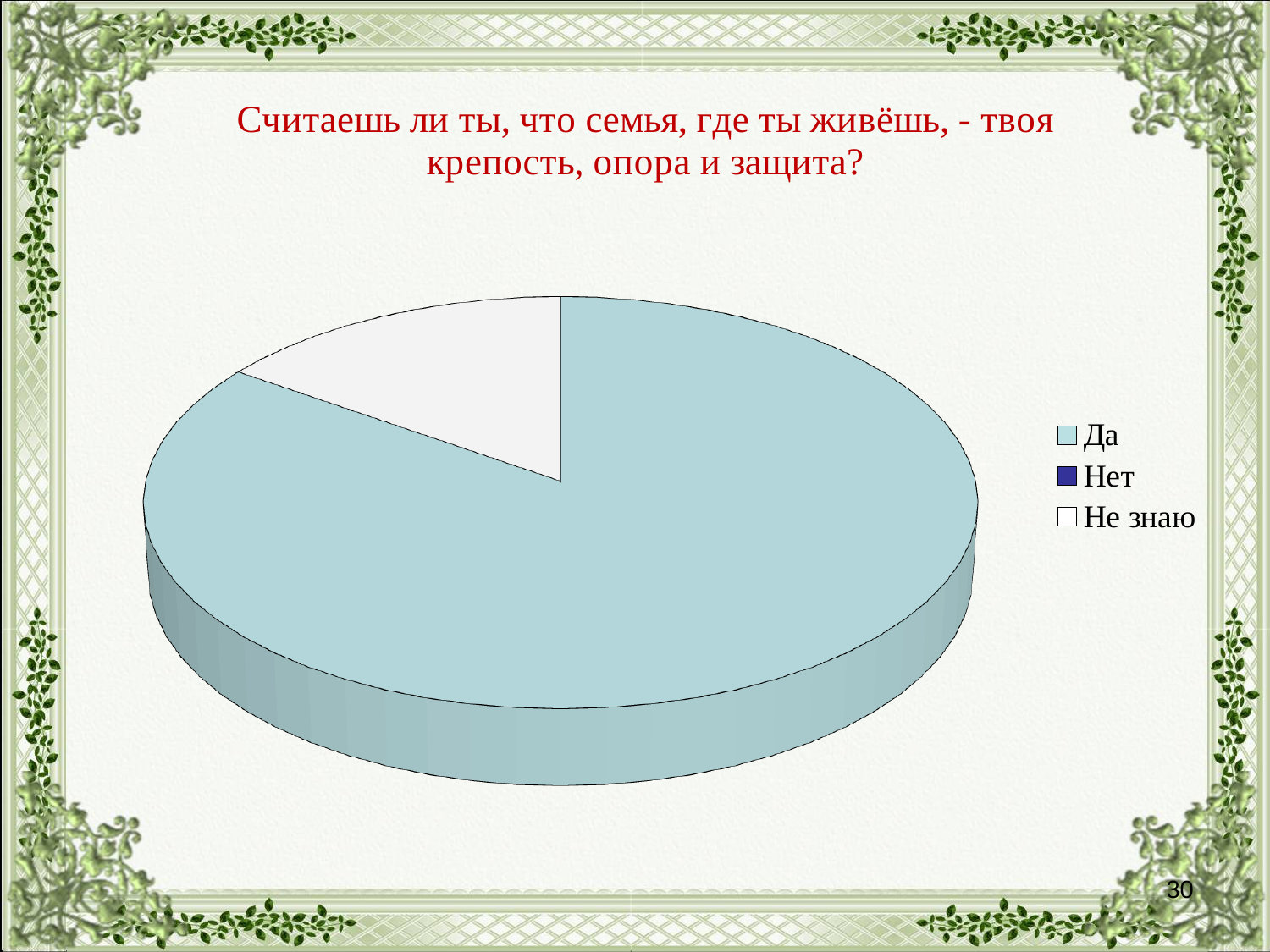
What kind of chart is shown on the slide? pie chart What colour is the Да slice in the pie chart? light blue How many categories does the legend of the pie chart list? 3 Which slice is larger, Да or Не знаю? Да Which legend category is not visible as a slice in the pie chart? Нет What are the three legend entries of the pie chart? Да, Нет, Не знаю Is the share of the pie for Да greater or less than 50%? greater Which category has the largest slice of the pie chart? Да